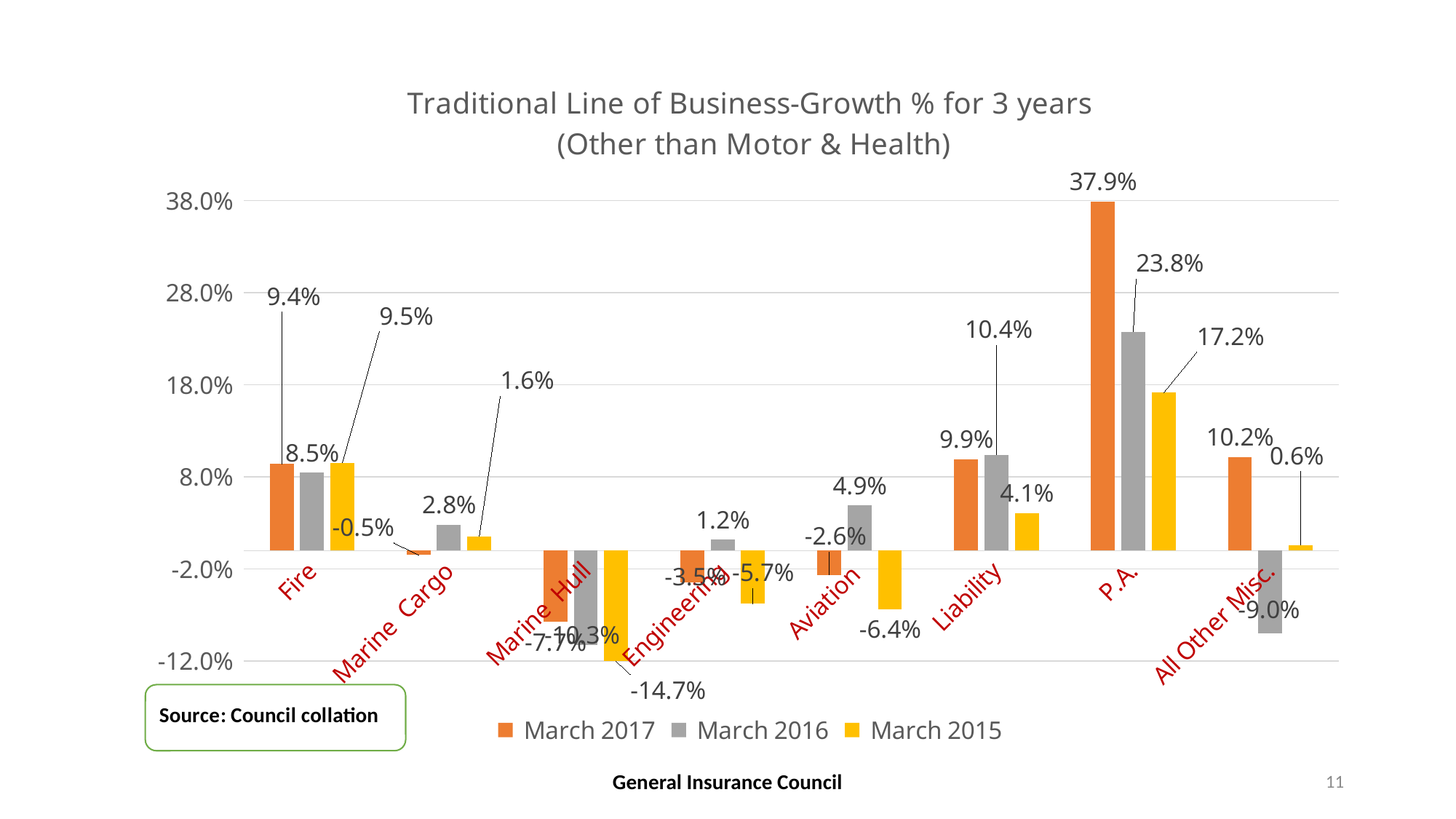
What kind of chart is shown on the slide? Bar chart Which line of business has the lowest March 2015 growth? Marine Hull What is the March 2017 growth value for P.A.? 37.9% What is the March 2016 growth value for All Other Misc.? -9.0% How many series does the legend list? 3 How many lines of business are shown on the x axis? 8 For Liability, which is larger: the March 2017 value or the March 2016 value? March 2016 What is the March 2016 growth value for Aviation? 4.9% What is the March 2015 growth value for Fire? 9.5% What is the title of the chart? Traditional Line of Business-Growth % for 3 years (Other than Motor & Health) Which line of business has the highest March 2017 growth? P.A. What is the difference between the March 2017 and March 2016 growth values for P.A.? 14.1 percentage points